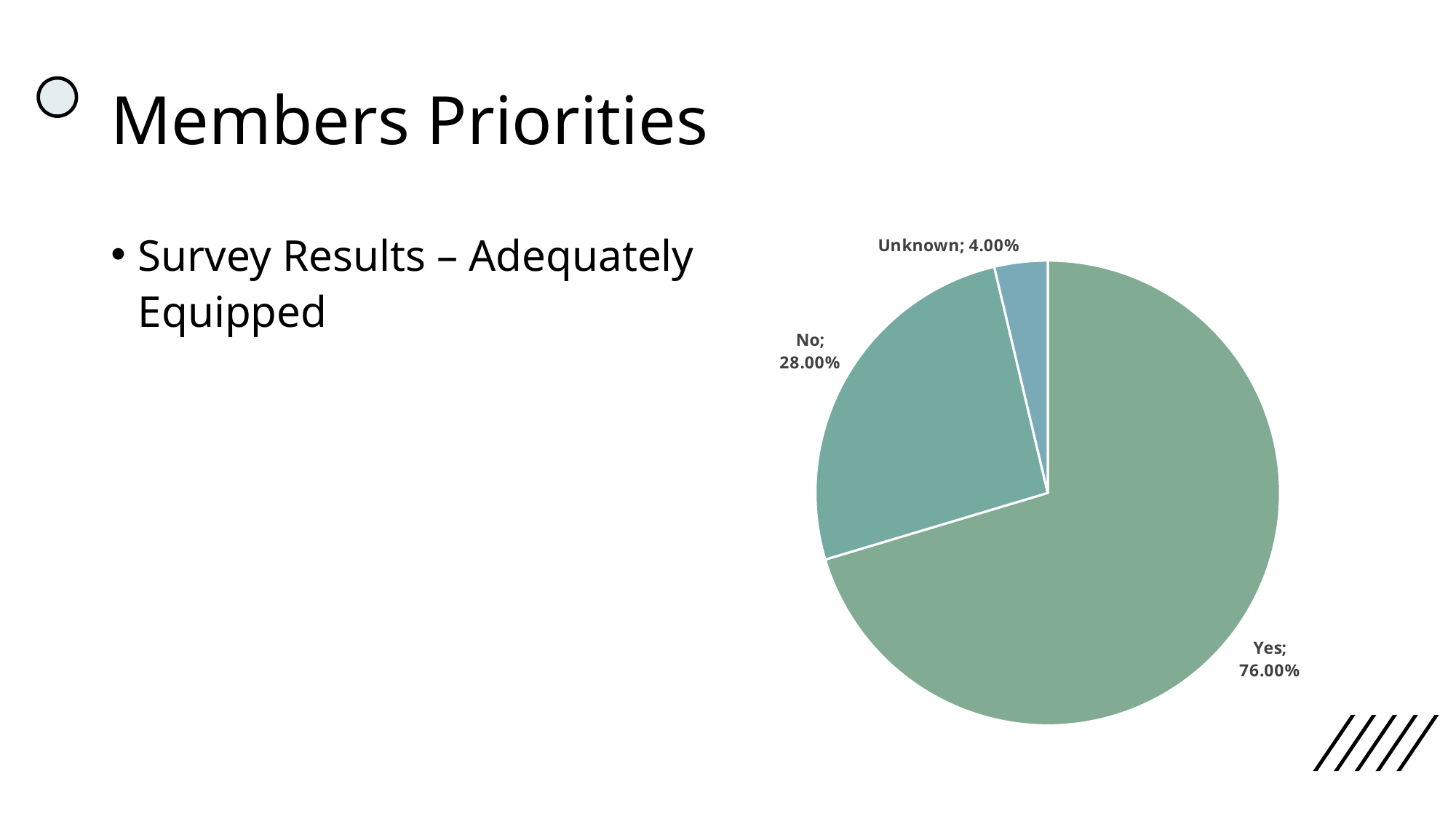
What percentage of the pie is labelled "No"? 28.00% Which slice of the pie is the largest? Yes Which slice is larger, "No" or "Unknown"? No What kind of chart is shown on the slide? pie chart What is the difference in percentage points between the "No" slice and the "Unknown" slice? 24.00% Is the "Yes" slice greater or less than 50% of the pie? greater What survey question do the pie chart results relate to, according to the bullet text? Adequately Equipped What percentage of the pie is labelled "Unknown"? 4.00% What is the difference in percentage points between the "Yes" slice and the "No" slice? 48.00% What percentage of the pie is labelled "Yes"? 76.00% How many slices does the pie chart have? 3 Which slice of the pie is the smallest? Unknown